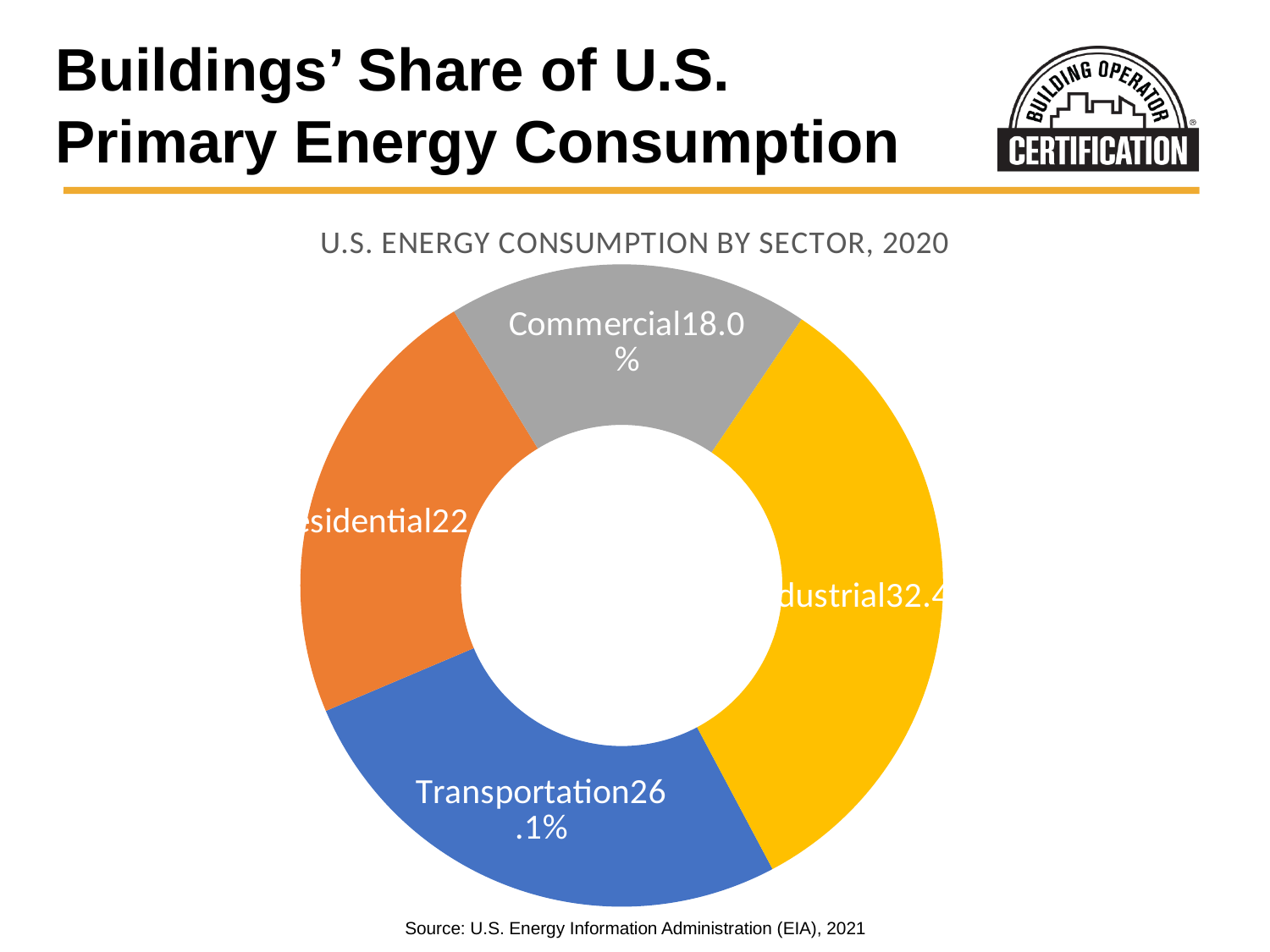
What colour is the Transportation slice in the chart? Blue How many sectors are shown in the chart? 4 Which sector has a larger share, Transportation or Commercial? Transportation What share of U.S. energy consumption does the Transportation sector account for? 26.1% What share of U.S. energy consumption does the Commercial sector account for? 18.0% Which sector has the largest share of U.S. energy consumption in the chart? Industrial Which sector has the smallest share of U.S. energy consumption in the chart? Commercial What type of chart is shown on the slide? Doughnut (pie) chart By how many percentage points does the Transportation share exceed the Commercial share? 8.1 percentage points Which sector has a larger share, Industrial or Transportation? Industrial What is the title of the chart? U.S. ENERGY CONSUMPTION BY SECTOR, 2020 Which sector has a larger share, Residential or Commercial? Residential